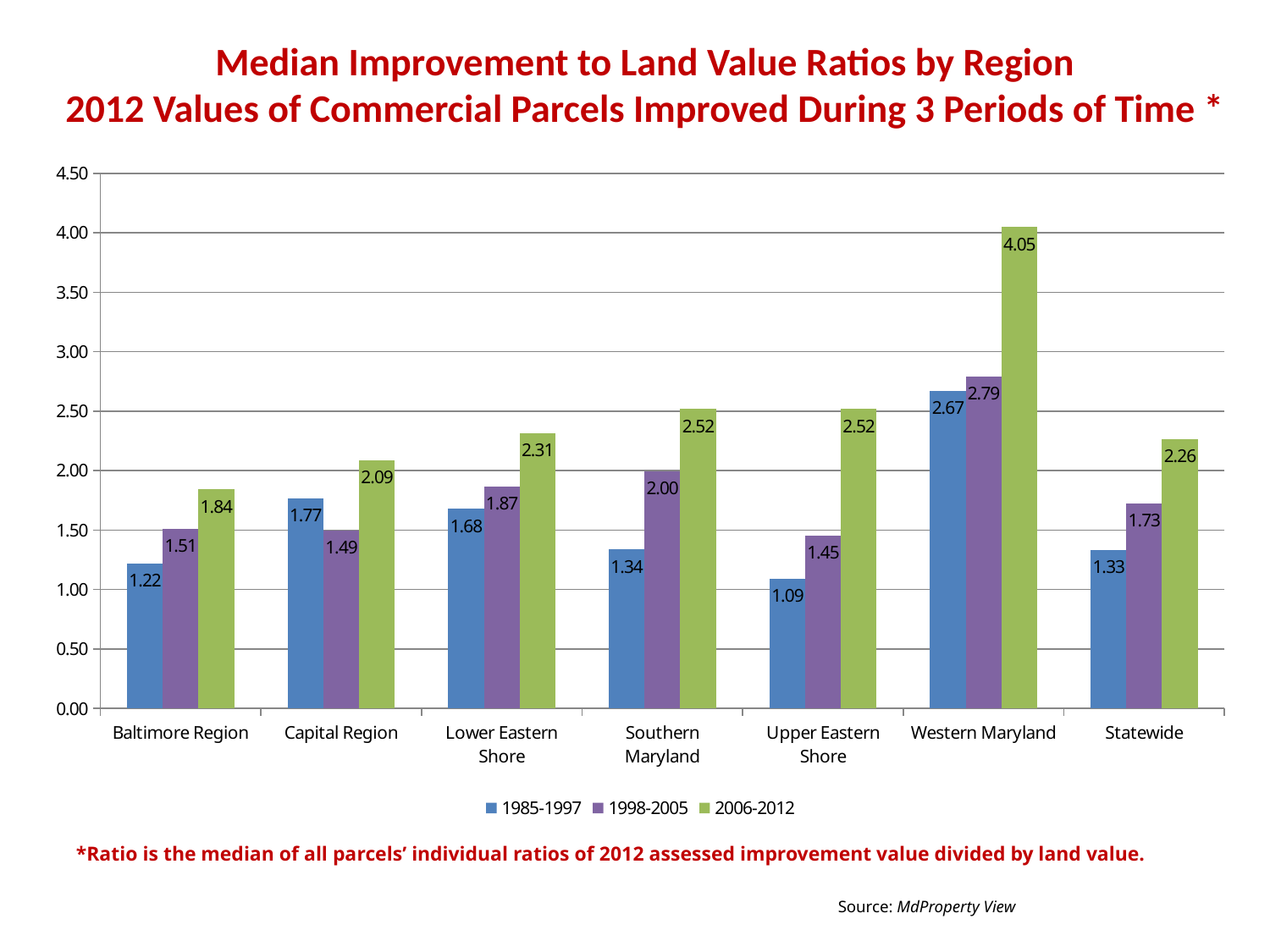
Which colour represents the 2006-2012 series? Green What is the difference between the 2006-2012 and 1985-1997 values for Southern Maryland? 1.18 How many series does the legend list? 3 Which region has the highest 2006-2012 value? Western Maryland What is the 1998-2005 value for Statewide? 1.73 Which region has the lowest 1985-1997 value? Upper Eastern Shore What is the 1985-1997 value for Upper Eastern Shore? 1.09 How many regions (categories) are shown on the x axis? 7 Is the 1998-2005 value for Western Maryland greater or less than 2.50? greater Which is larger for the Capital Region: the 1985-1997 value or the 1998-2005 value? 1985-1997 What is the 2006-2012 value for Western Maryland? 4.05 What kind of chart is shown on the slide? Bar chart